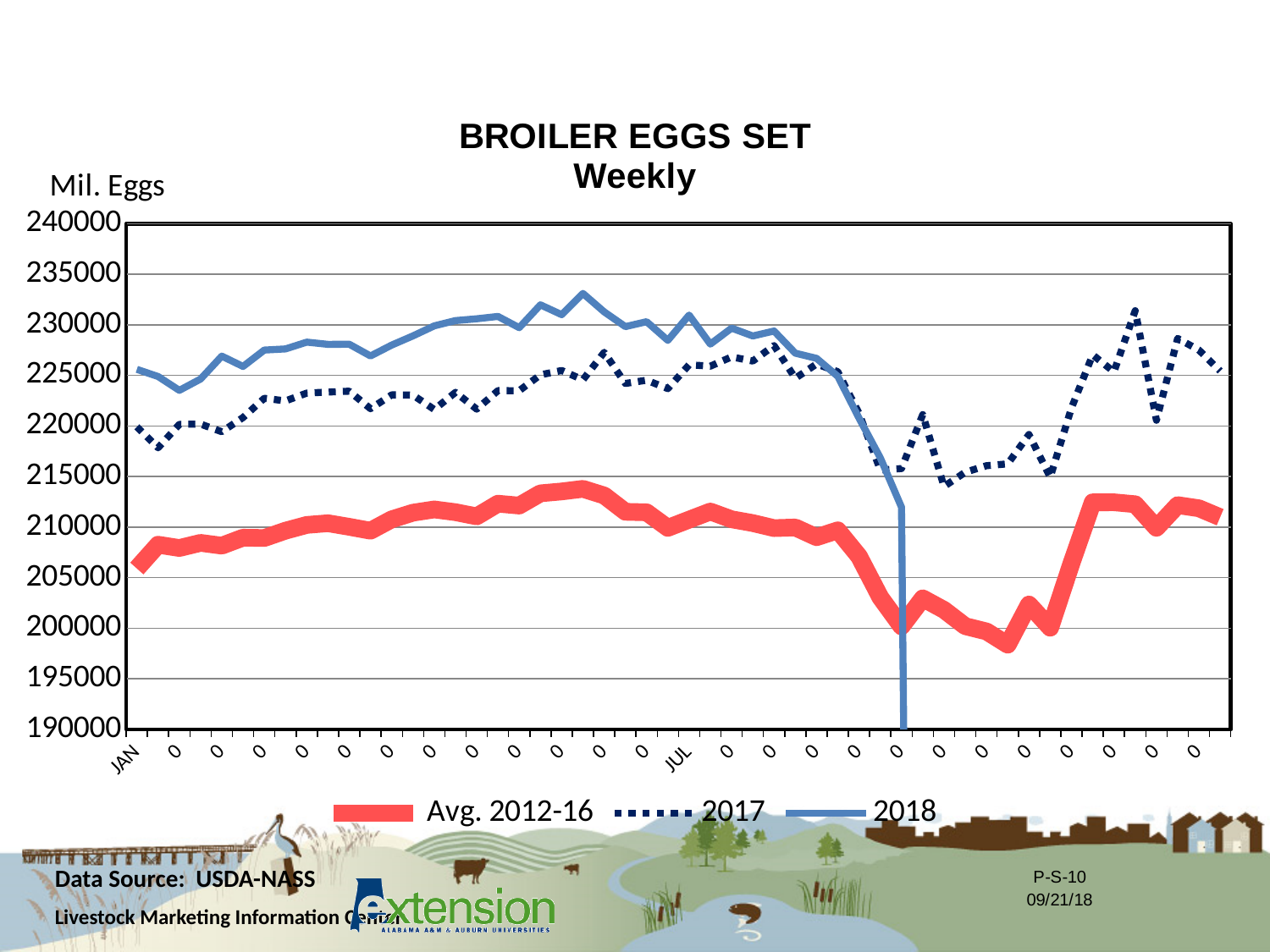
What is the title of the chart? BROILER EGGS SET Weekly Which series is drawn as a dashed line? 2017 At JAN, which series has the higher value, 2018 or 2017? 2018 Is the 2017 value at JAN greater or less than 225000? less Is the 2017 value at JUL greater or less than 220000? greater Is the 2018 value at JAN greater or less than 220000? greater What kind of chart is shown on the slide? line chart How many series does the legend list? 3 At JUL, which series has the higher value, Avg. 2012-16 or 2017? 2017 Does the 2018 line rise or fall from JAN to JUL? rise